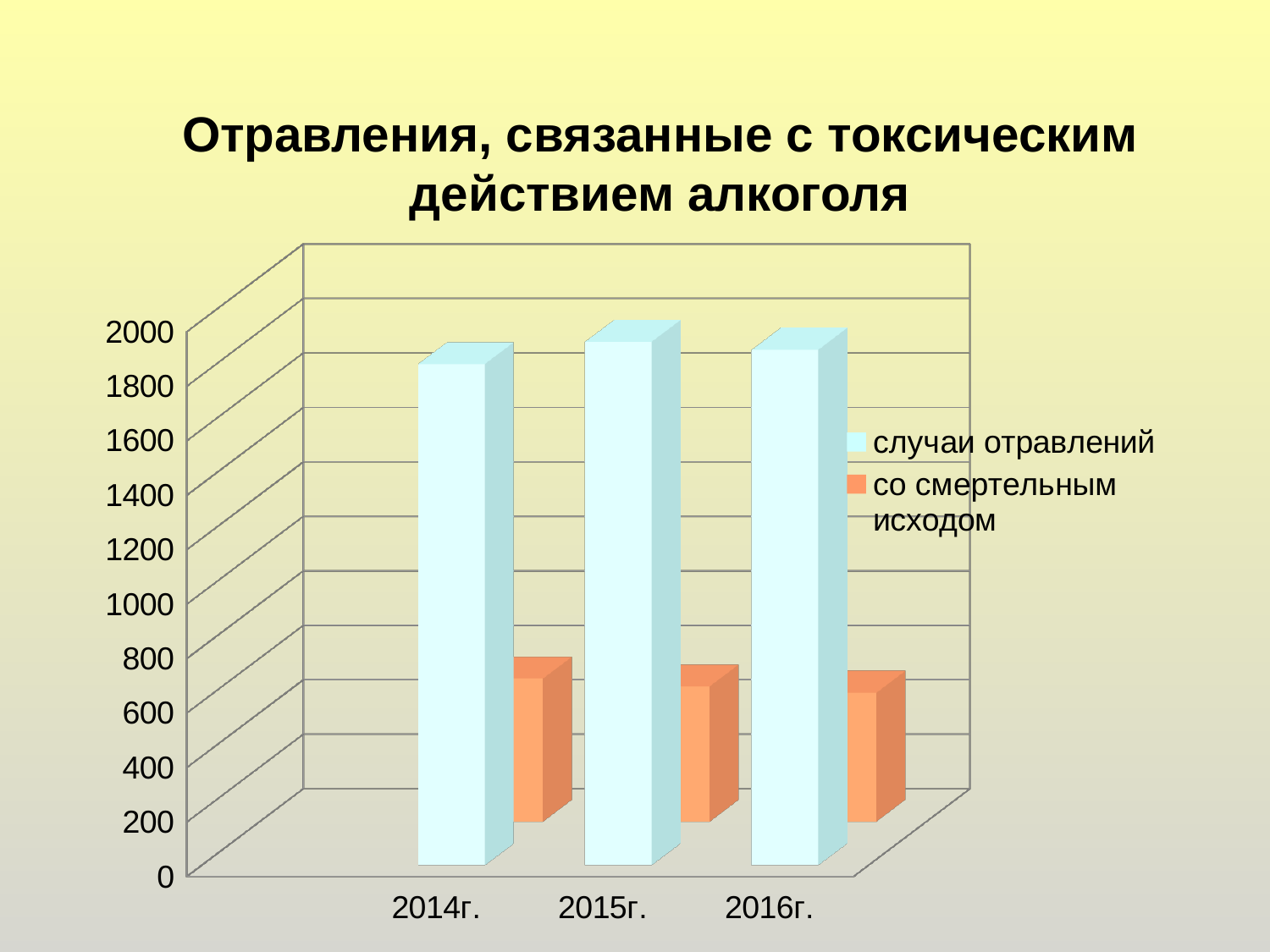
Which series is shown in orange? со смертельным исходом Is the value for "со смертельным исходом" in 2015г. greater or less than 1200? less How many series does the legend list? 2 Is the value for "случаи отравлений" in 2014г. greater or less than 1000? greater How many years are shown on the x axis? 3 Is the value for "со смертельным исходом" in 2014г. greater or less than 1000? less Which year has the lowest value for "случаи отравлений"? 2014г. In 2016г., which is larger: "случаи отравлений" or "со смертельным исходом"? случаи отравлений What kind of chart is shown on the slide? bar chart What is the title of the chart? Отравления, связанные с токсическим действием алкоголя